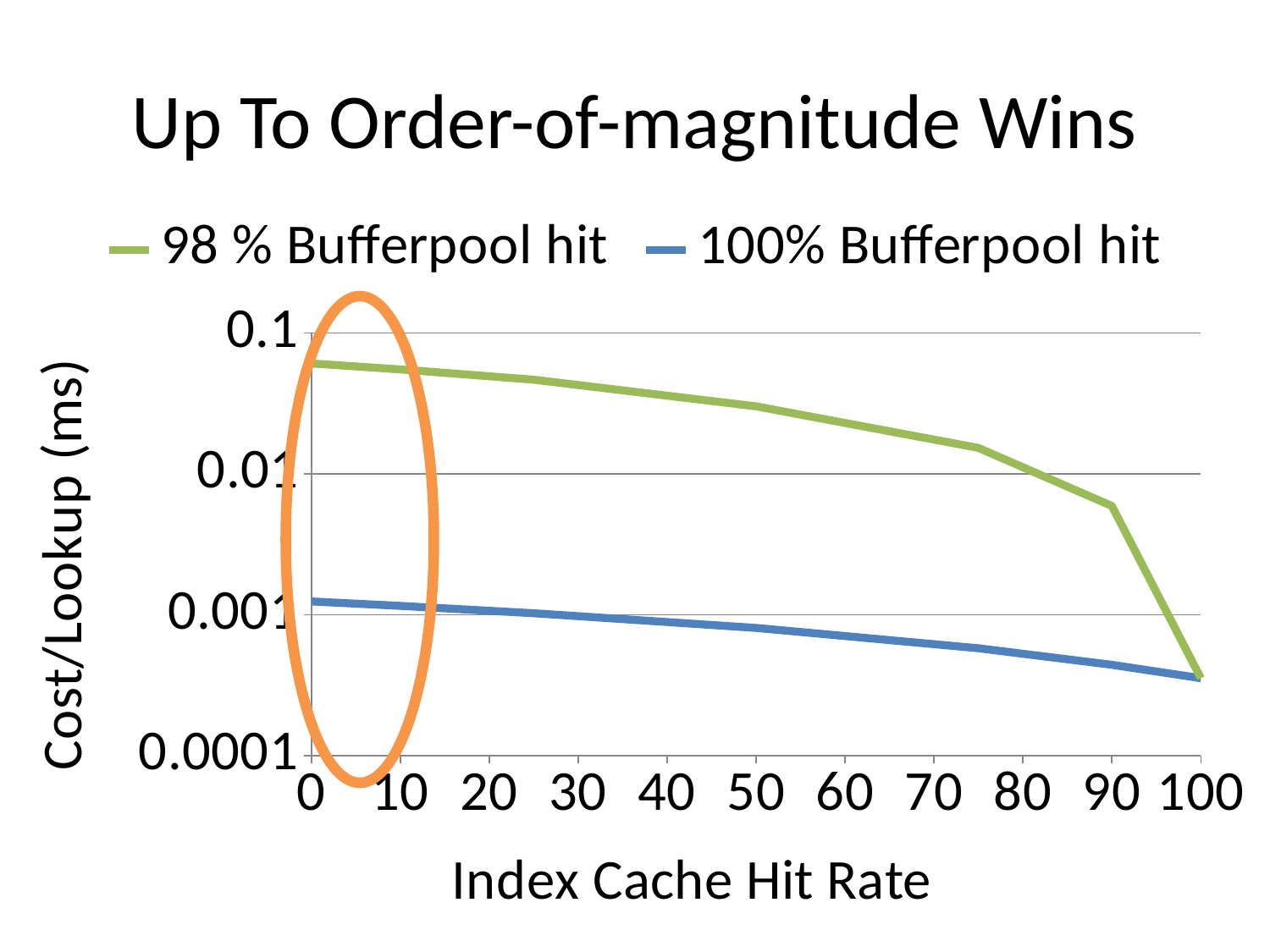
What is the label of the y axis? Cost/Lookup (ms) Is the value for 98 % Bufferpool hit at an Index Cache Hit Rate of 90 greater or less than 0.01? less What kind of chart is shown on the slide? line chart Is the value for 100% Bufferpool hit at an Index Cache Hit Rate of 50 greater or less than 0.001? less What is the title of the chart? Up To Order-of-magnitude Wins At an Index Cache Hit Rate of 50, which series has the higher Cost/Lookup: 98 % Bufferpool hit or 100% Bufferpool hit? 98 % Bufferpool hit Is the value for 98 % Bufferpool hit at an Index Cache Hit Rate of 0 greater or less than 0.01? greater How many series does the legend list? 2 Does the Cost/Lookup for 100% Bufferpool hit rise or fall as the Index Cache Hit Rate increases from 0 to 100? fall Does the Cost/Lookup for 98 % Bufferpool hit rise or fall as the Index Cache Hit Rate increases from 0 to 100? fall